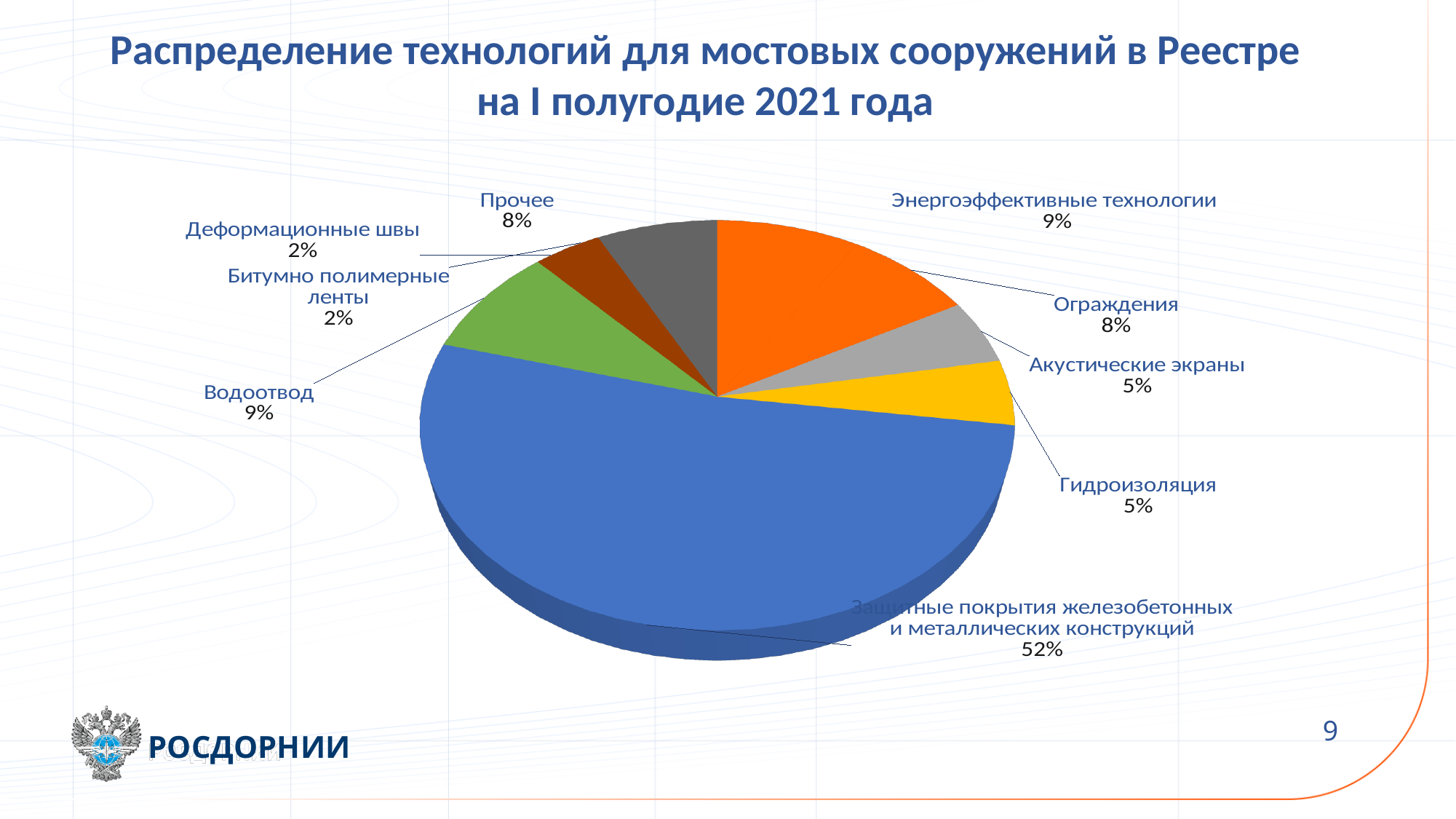
What kind of chart is shown on the slide? pie chart What share is shown for Прочее? 8% What is the difference between the shares for Защитные покрытия железобетонных и металлических конструкций and Энергоэффективные технологии? 43% What share of the pie is labelled for Защитные покрытия железобетонных и металлических конструкций? 52% Which category has the largest slice of the pie? Защитные покрытия железобетонных и металлических конструкций What is the difference between the shares for Водоотвод and Деформационные швы? 7% What share is shown for Акустические экраны? 5% What share is shown for Энергоэффективные технологии? 9% What is the title of the chart on the slide? Распределение технологий для мостовых сооружений в Реестре на I полугодие 2021 года What share is shown for Битумно полимерные ленты? 2% How many slices does the pie chart have? 9 Which is larger, the share for Ограждения or the share for Гидроизоляция? Ограждения